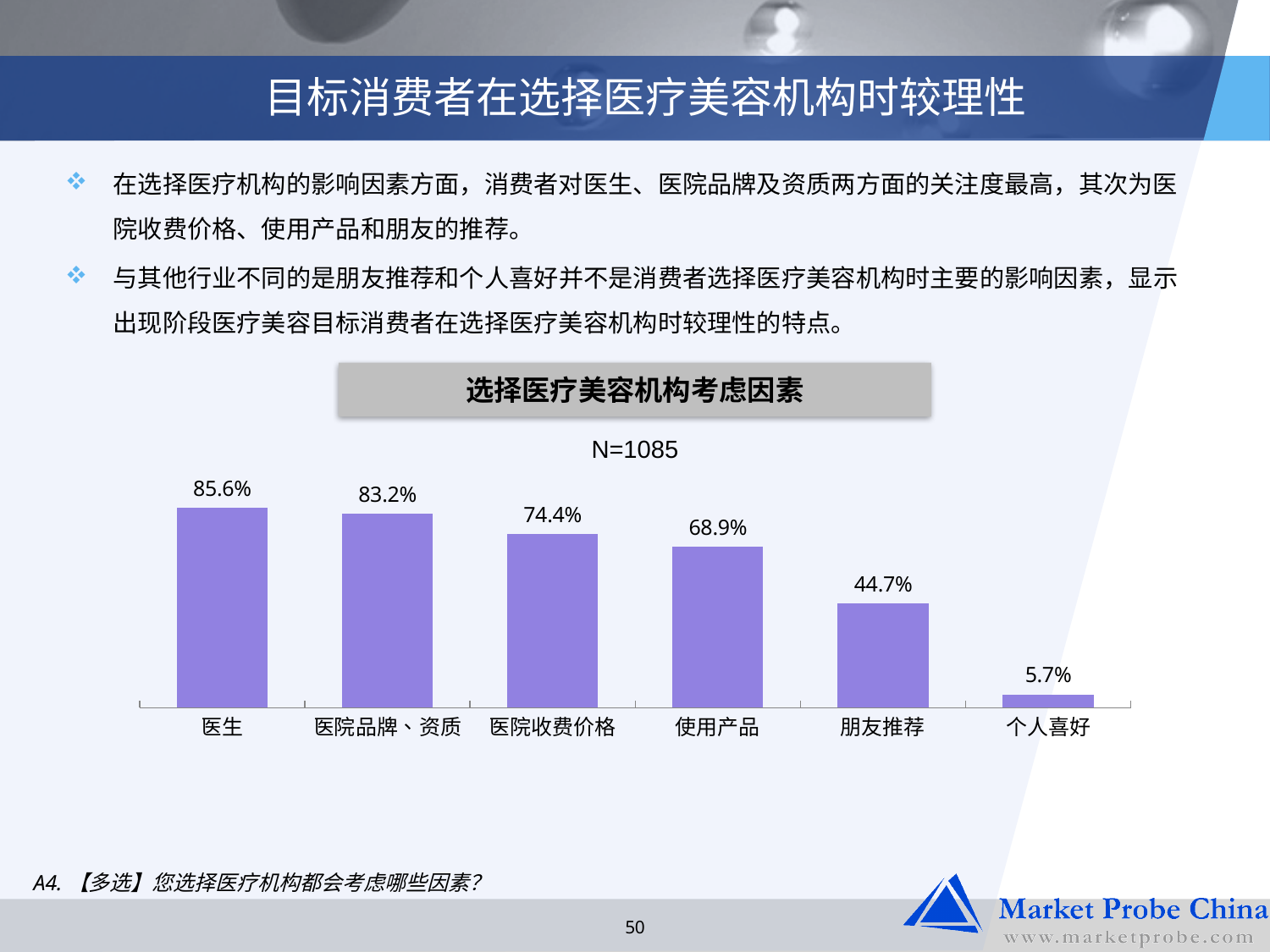
Do the values rise or fall from left to right along the x axis? fall What is the title of the chart? 选择医疗美容机构考虑因素 What is the value for 朋友推荐? 44.7% What kind of chart is shown on the slide? bar chart Which is larger, the value for 医院收费价格 or the value for 使用产品? 医院收费价格 How many categories are shown in the chart? 6 What is the difference between the values for 使用产品 and 朋友推荐? 24.2% What is the value for 医院收费价格? 74.4% Which category has the lowest value? 个人喜好 What is the value for 医生? 85.6% Which category has the highest value? 医生 What is the difference between the values for 医生 and 医院品牌、资质? 2.4%